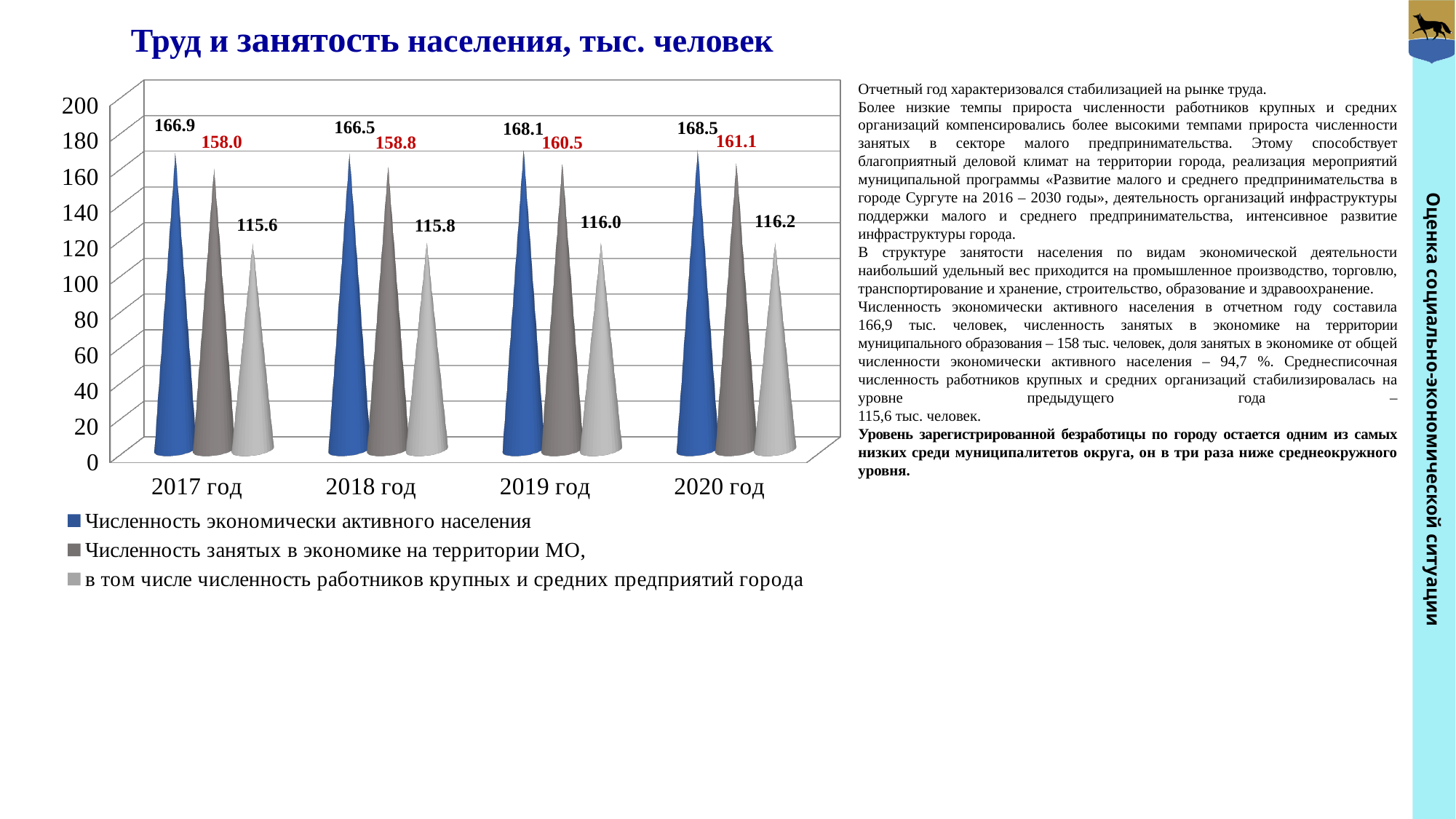
Which is larger: 'Численность занятых в экономике на территории МО' in 2018 год or in 2019 год? 2019 год Does 'Численность занятых в экономике на территории МО' rise or fall from 2017 год to 2020 год? Rise In which year is 'Численность экономически активного населения' the highest? 2020 год What is the difference between 'Численность экономически активного населения' and 'Численность занятых в экономике на территории МО' in 2020 год? 7.4 In which year is 'в том числе численность работников крупных и средних предприятий города' the lowest? 2017 год What is the title of the chart? Труд и занятость населения, тыс. человек What is the value of 'Численность занятых в экономике на территории МО' for 2017 год? 158.0 How many years are shown on the x axis? 4 What is the value of 'Численность экономически активного населения' for 2019 год? 168.1 How many series does the legend list? 3 What kind of chart is shown on the slide? Bar chart What is the value of 'в том числе численность работников крупных и средних предприятий города' for 2020 год? 116.2